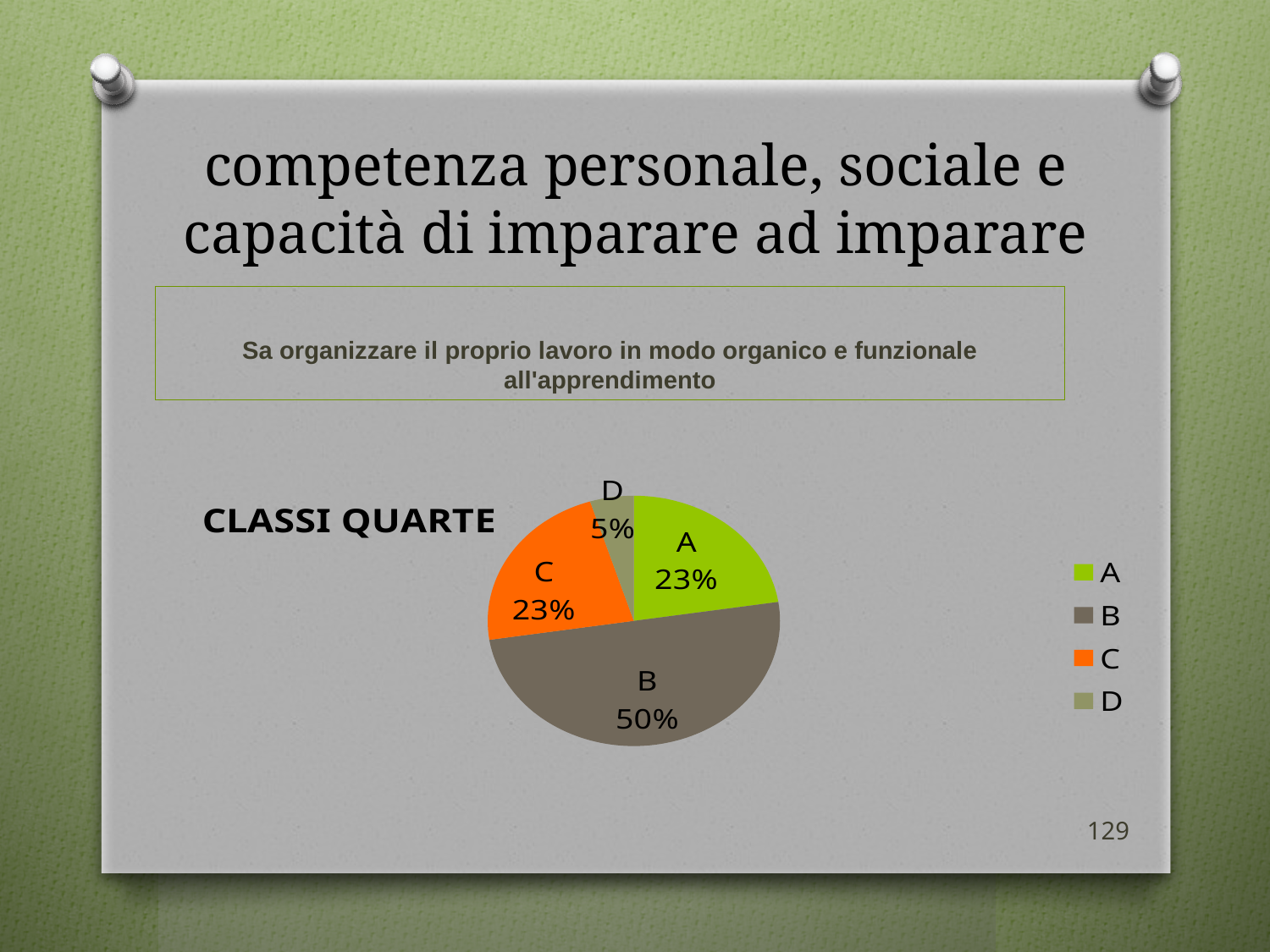
What label appears to the left of the pie chart? CLASSI QUARTE What is the difference between the values for B and D? 45% What is the value shown for slice D? 5% What share of the pie does slice B represent? 50% What is the value shown for slice A? 23% What type of chart is shown on the slide? pie chart Which is larger, the value for B or the value for A? B How many entries does the legend list? 4 How many slices does the pie chart have? 4 Which slice is the smallest in the pie chart? D Which slice is the largest in the pie chart? B What is the value shown for slice C? 23%